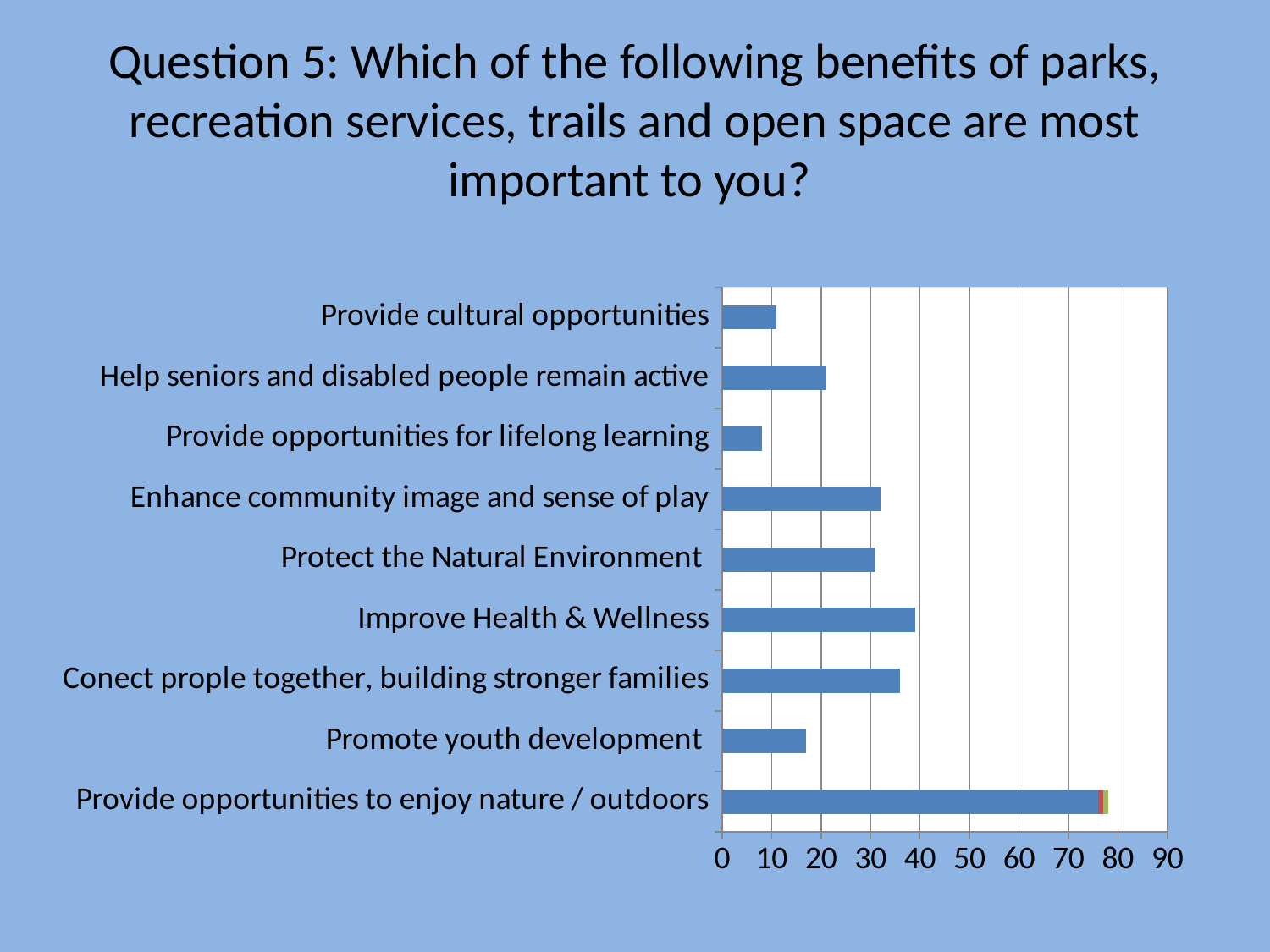
What kind of chart is shown on the slide? bar chart Is the value for "Help seniors and disabled people remain active" greater or less than 30? less Which benefit has the lowest value in the chart? Provide opportunities for lifelong learning What is the highest value shown on the horizontal axis of the chart? 90 How many categories (benefits) are plotted in the chart? 9 Which has a larger value: "Enhance community image and sense of play" or "Provide cultural opportunities"? Enhance community image and sense of play Which has a larger value: "Improve Health & Wellness" or "Promote youth development"? Improve Health & Wellness Is the value for "Improve Health & Wellness" greater or less than 30? greater Which benefit has the highest value in the chart? Provide opportunities to enjoy nature / outdoors Is the value for "Provide opportunities to enjoy nature / outdoors" greater or less than 70? greater